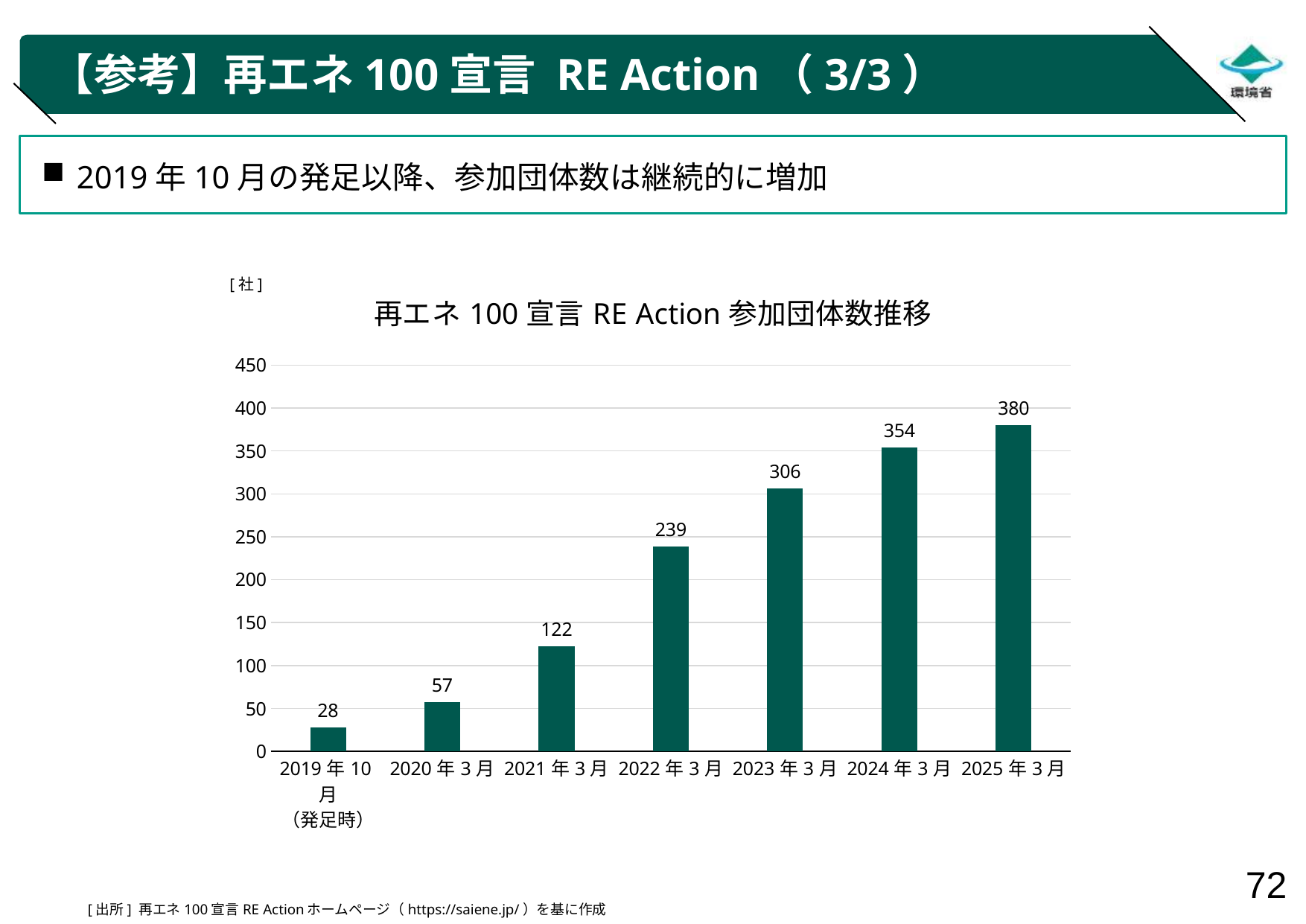
What is the value for 2021年3月? 122 Which is larger, the value for 2022年3月 or 2023年3月? 2023年3月 Do the values rise or fall from 2019年10月 to 2025年3月? rise What type of chart is shown on the slide? bar chart What is the difference between the values for 2025年3月 and 2024年3月? 26 Which period has the highest number of participating organizations? 2025年3月 How many time points are plotted in the chart? 7 Is the value for 2024年3月 greater or less than 350? greater How much did the number increase from 2020年3月 to 2022年3月? 182 What is the number of participating organizations in 2023年3月? 306 Which period has the lowest value in the chart? 2019年10月（発足時） What value is shown for 2019年10月（発足時）? 28